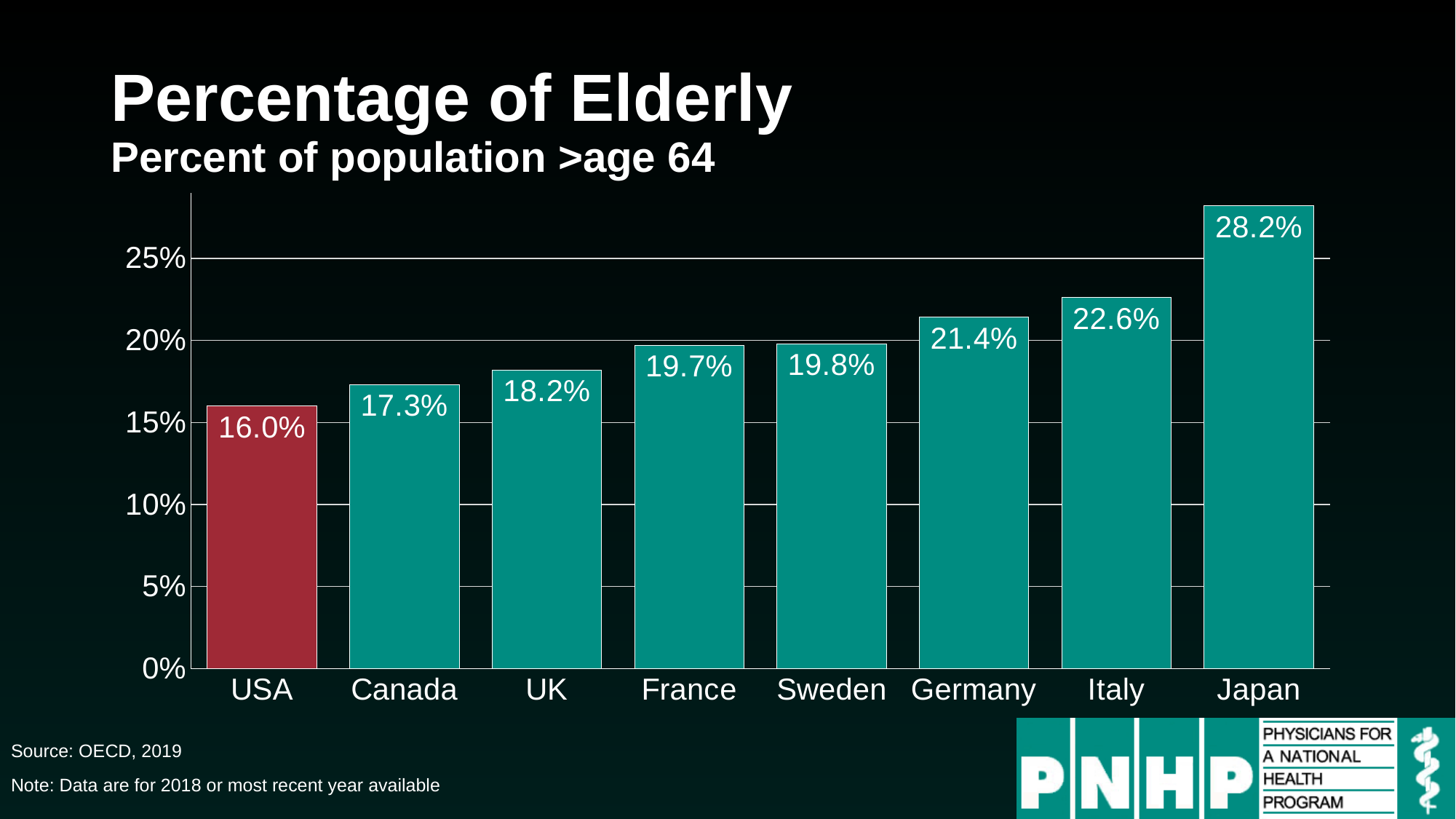
What is the percentage of population over age 64 for Japan? 28.2% Is the value for Italy greater or less than 20%? greater Which has a larger value, Germany or France? Germany What kind of chart is shown on the slide? Bar chart What is the value shown for the USA? 16.0% What is the difference between Italy's value and Canada's value? 5.3% What is the difference between Japan's value and the USA's value? 12.2% Which country's bar is coloured red rather than teal? USA What is the value shown for Germany? 21.4% How many countries are shown in the chart? 8 Which country has the lowest percentage of elderly? USA Which country has the highest percentage of elderly? Japan